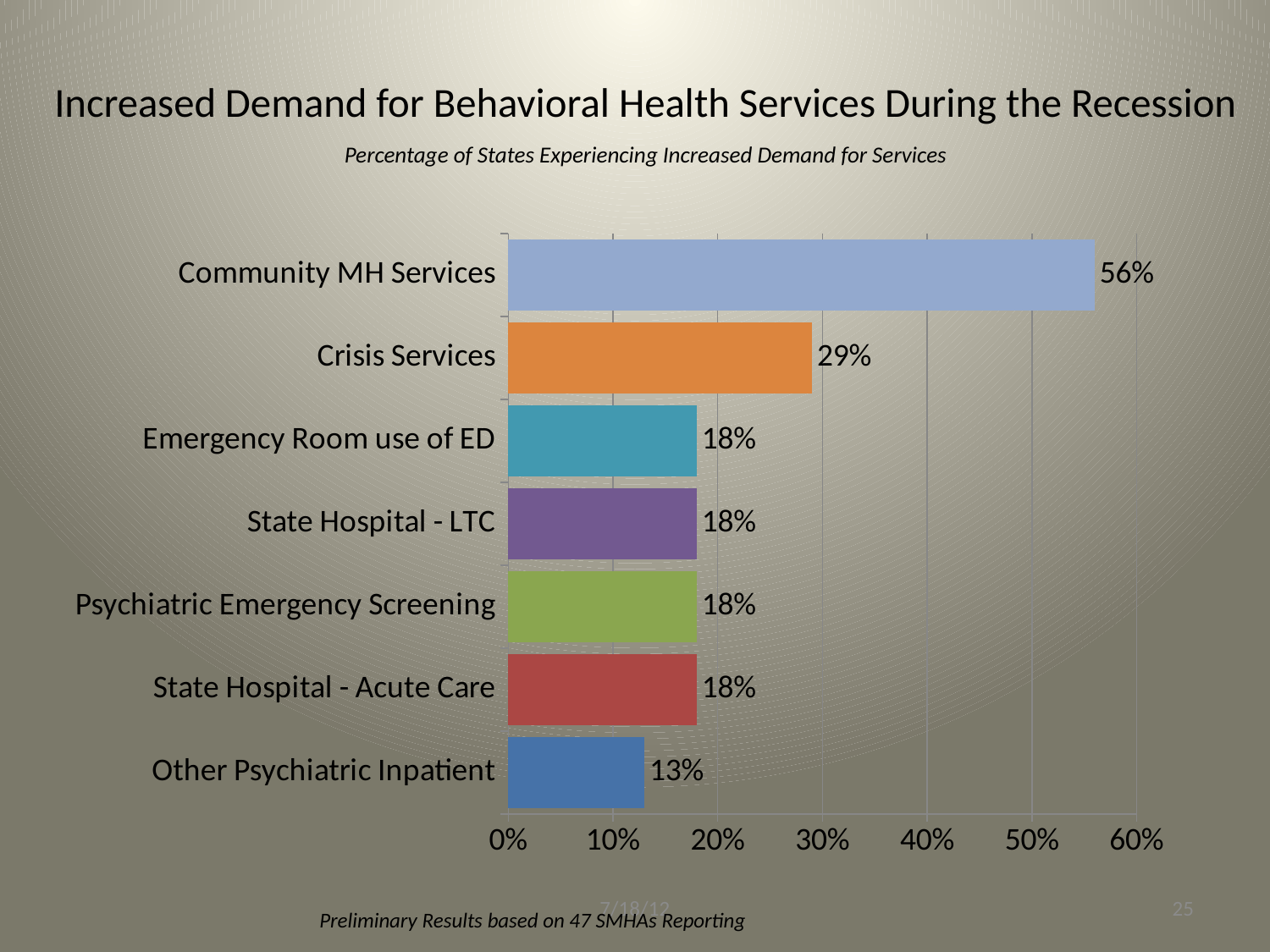
Is the value for Community MH Services greater or less than 50%? greater What percentage of states reported increased demand for Community MH Services? 56% What kind of chart is shown on the slide? Bar chart What percentage is shown for Other Psychiatric Inpatient? 13% How many categories are shown in the chart? 7 Which category has the highest percentage of states reporting increased demand? Community MH Services What is the value shown for Crisis Services? 29% Which is larger, the value for Crisis Services or the value for Emergency Room use of ED? Crisis Services What is the difference between the values for Community MH Services and Crisis Services? 27% How many categories share the value 18%? 4 Which category has the lowest percentage? Other Psychiatric Inpatient What is the value for State Hospital - Acute Care? 18%